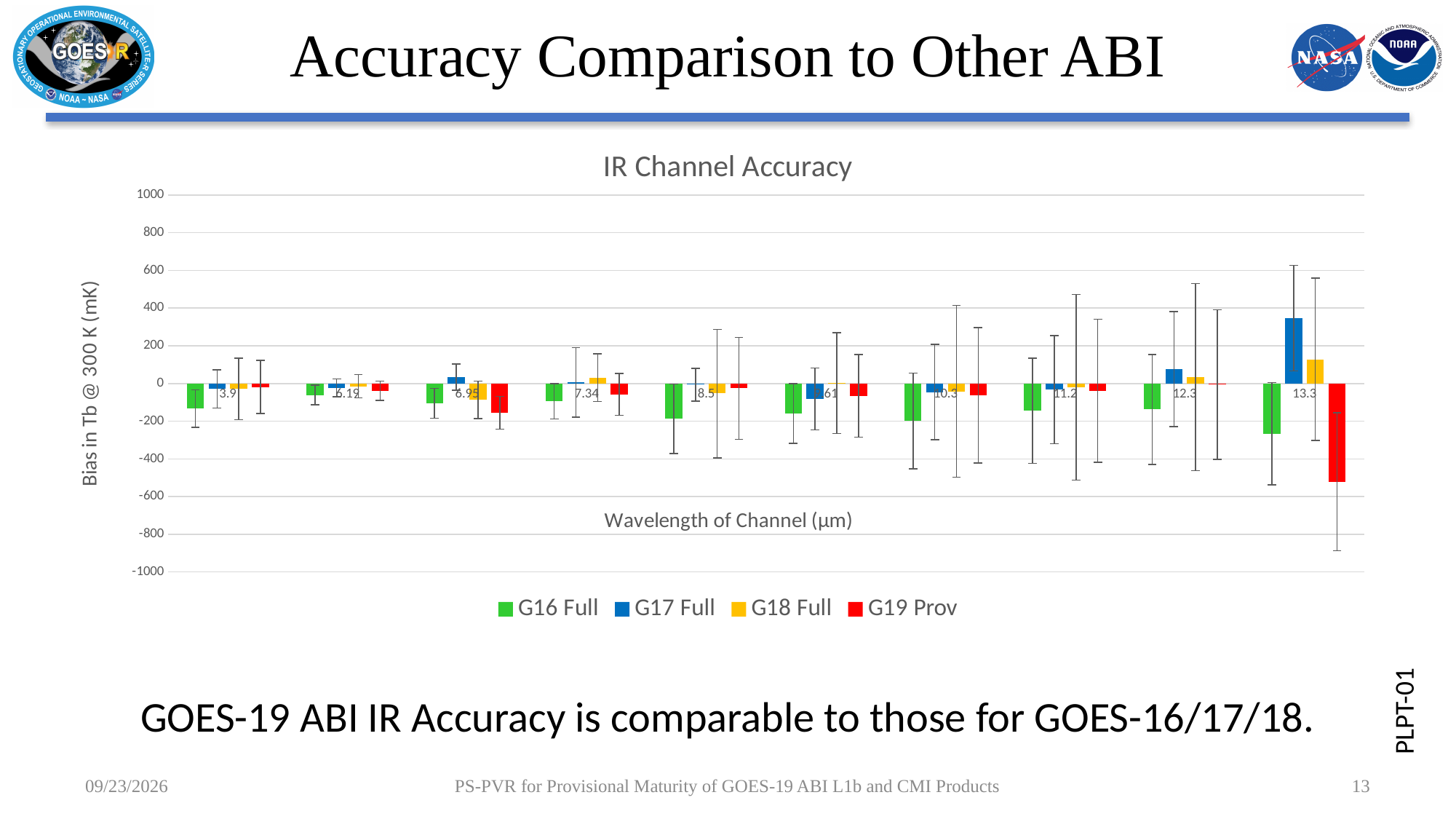
What is the y-axis label of the chart? Bias in Tb @ 300 K (mK) Is the G17 Full value at 13.3 greater or less than 200? greater What type of chart is shown on the slide? bar chart How many wavelength categories are shown on the x axis? 10 Is the G19 Prov value at 13.3 greater or less than -400? less Which series has the highest positive bar in the chart? G17 Full At which wavelength does the G19 Prov series have its lowest bar? 13.3 How many series does the legend list? 4 Which series has the lowest (most negative) bar in the chart? G19 Prov Is the G16 Full value at 13.3 greater or less than -200? less What is the title of the chart? IR Channel Accuracy At 13.3, which is larger, the G16 Full value or the G19 Prov value? G16 Full